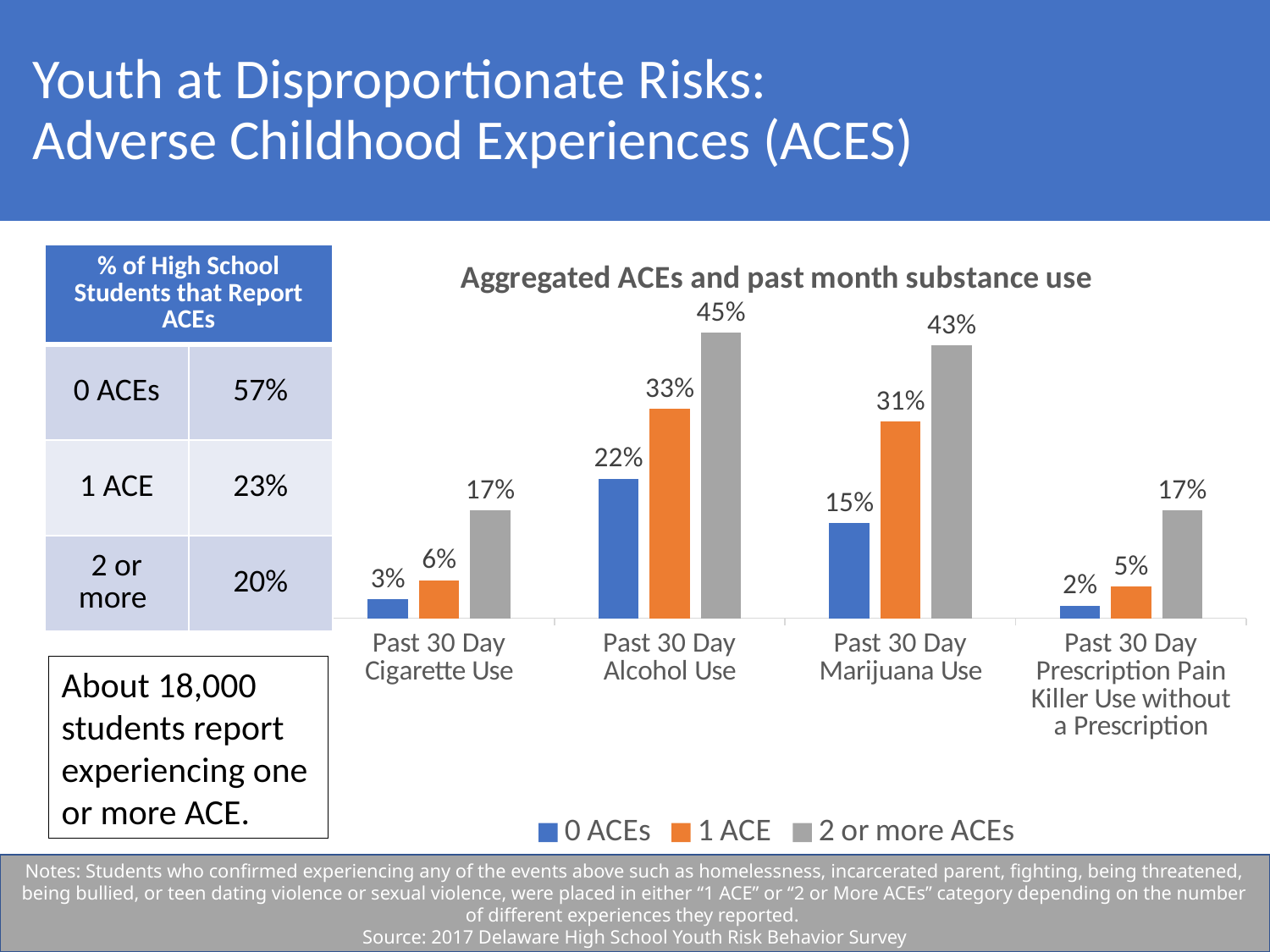
Which is larger for Past 30 Day Alcohol Use: the 1 ACE value or the 0 ACEs value? 1 ACE What is the value for 1 ACE for Past 30 Day Cigarette Use? 6% Which category has the lowest value for the 0 ACEs series? Past 30 Day Prescription Pain Killer Use without a Prescription What is the value for 2 or more ACEs for Past 30 Day Alcohol Use? 45% How many categories are shown on the x axis of the chart? 4 What is the difference between the 2 or more ACEs and 0 ACEs values for Past 30 Day Marijuana Use? 28% What is the value for 0 ACEs for Past 30 Day Marijuana Use? 15% What is the value for 0 ACEs for Past 30 Day Prescription Pain Killer Use without a Prescription? 2% What is the title of the chart? Aggregated ACEs and past month substance use What kind of chart is shown on the slide? Bar chart How many series does the legend list? 3 Which category has the highest value for the 2 or more ACEs series? Past 30 Day Alcohol Use